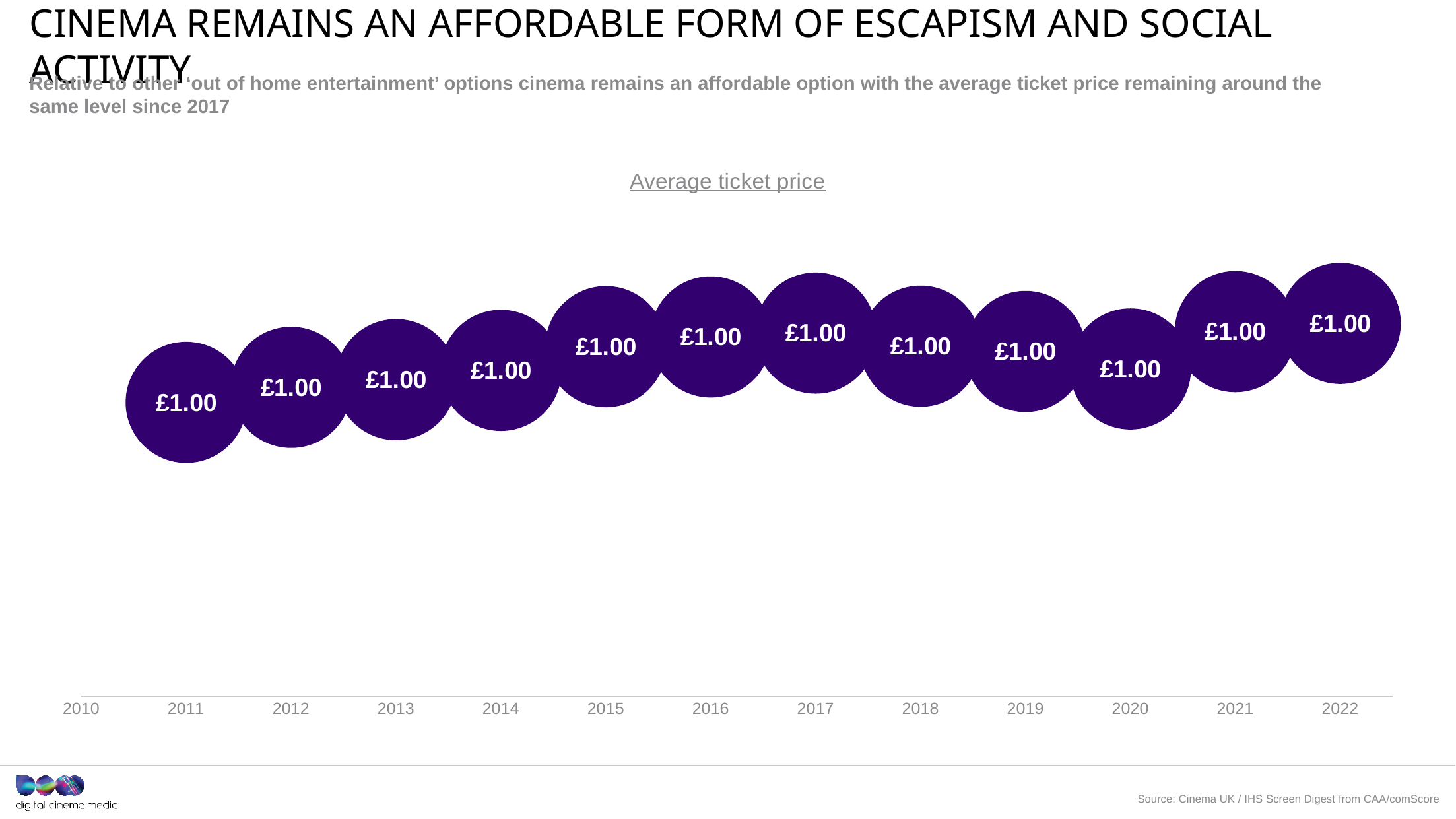
Which is the first year that has a bubble plotted on the chart? 2011 Which is the last year shown on the x axis? 2022 How many bubbles (data points) are plotted on the chart? 12 What colour are the bubbles in the chart? Purple What value is labelled on the bubble for 2015? £1.00 What kind of chart is shown on the slide? Bubble chart What is the title of the chart? Average ticket price What is the average ticket price shown for 2011? £1.00 What is the average ticket price shown for 2020? £1.00 What value is labelled on the bubble for 2017? £1.00 What is the average ticket price shown for 2022? £1.00 How many year labels are shown along the x axis? 13